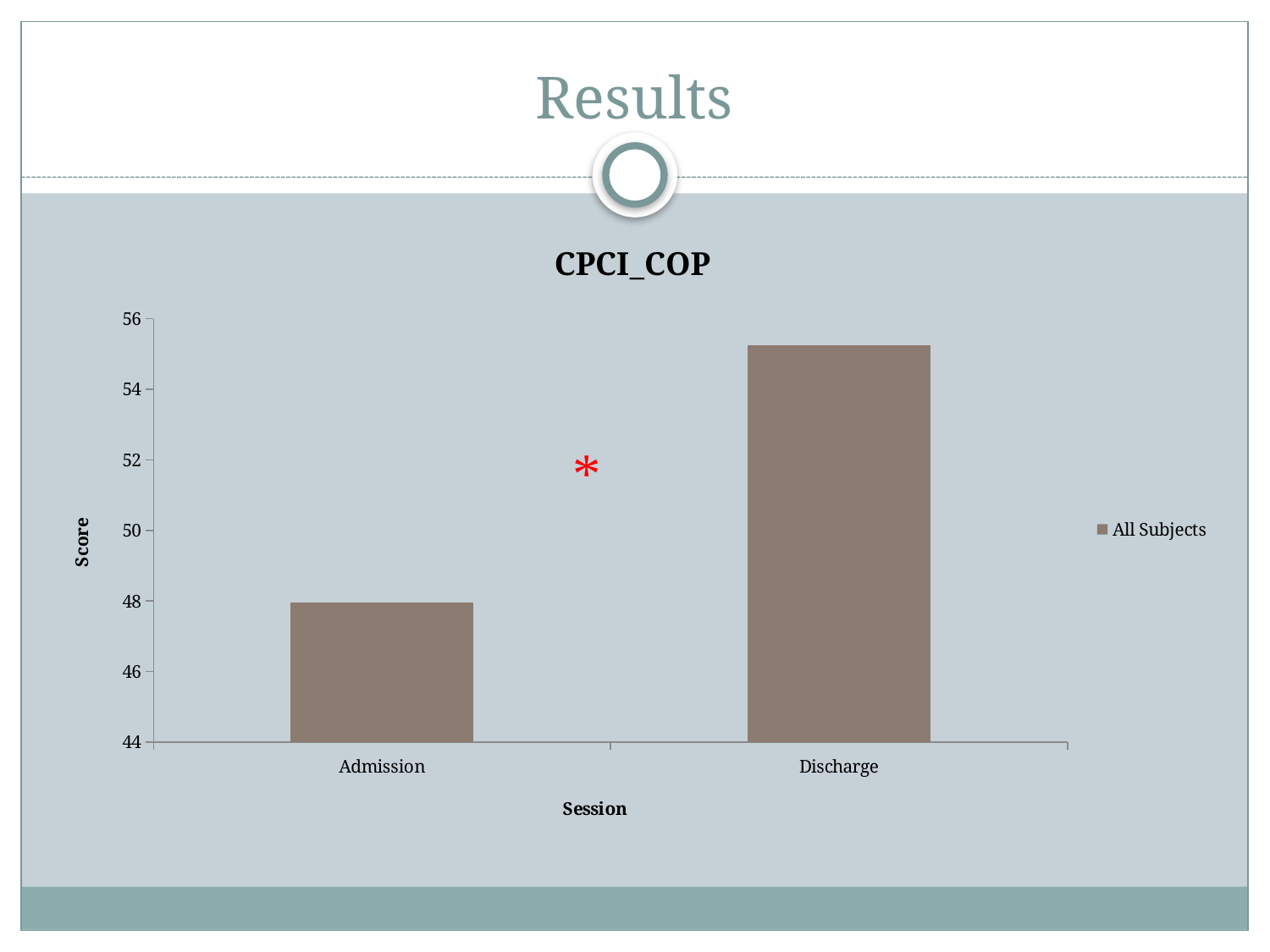
Which is larger, the score at Admission or at Discharge? Discharge Which session has the lowest score? Admission Which session has the highest score? Discharge How many series does the legend list? 1 Do the scores rise or fall from Admission to Discharge? rise What is the name of the series in the legend? All Subjects Is the score for Admission greater or less than 50? less Is the score for Discharge greater or less than 54? greater What kind of chart is shown on the slide? bar chart What is the title of the chart? CPCI_COP How many categories are shown on the x axis? 2 Is the score for Admission greater or less than 46? greater